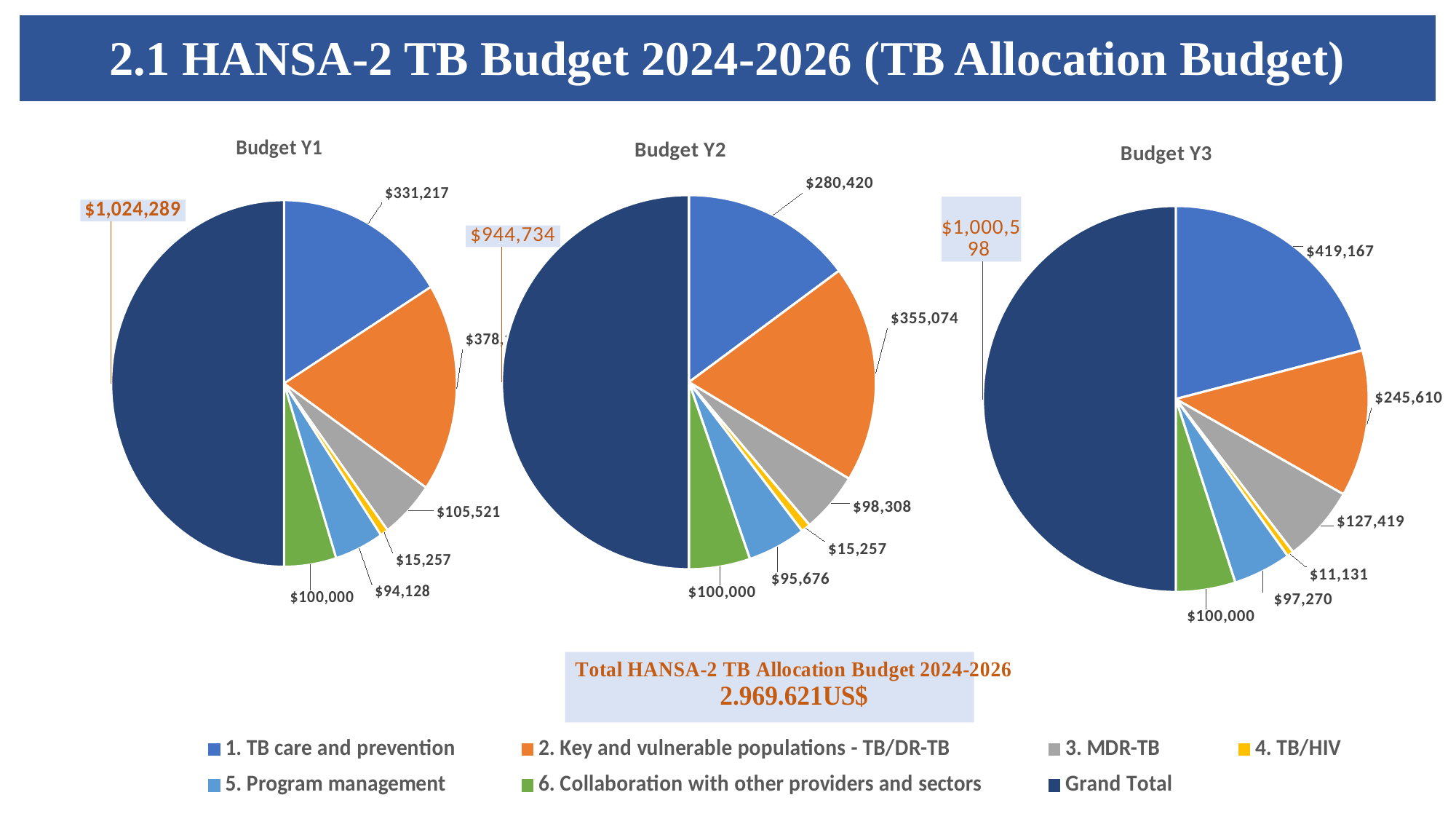
How many entries does the legend list? 7 In the Budget Y3 chart, what is the value for 4. TB/HIV? $11,131 In the Budget Y3 chart, which category has the largest slice? Grand Total In the Budget Y3 chart, what is the difference between 1. TB care and prevention and 2. Key and vulnerable populations - TB/DR-TB? $173,557 In the Budget Y1 chart, which category has the smallest slice? 4. TB/HIV In the Budget Y1 chart, what is the value for 1. TB care and prevention? $331,217 In the Budget Y2 chart, what is the value for Grand Total? $944,734 Which legend entry is shown in yellow? 4. TB/HIV What kind of chart is used for Budget Y1, Budget Y2 and Budget Y3? Pie chart In the Budget Y3 chart, what is the value for 3. MDR-TB? $127,419 In the Budget Y2 chart, which is larger: 5. Program management or 6. Collaboration with other providers and sectors? 6. Collaboration with other providers and sectors In the Budget Y2 chart, what is the value for 2. Key and vulnerable populations - TB/DR-TB? $355,074